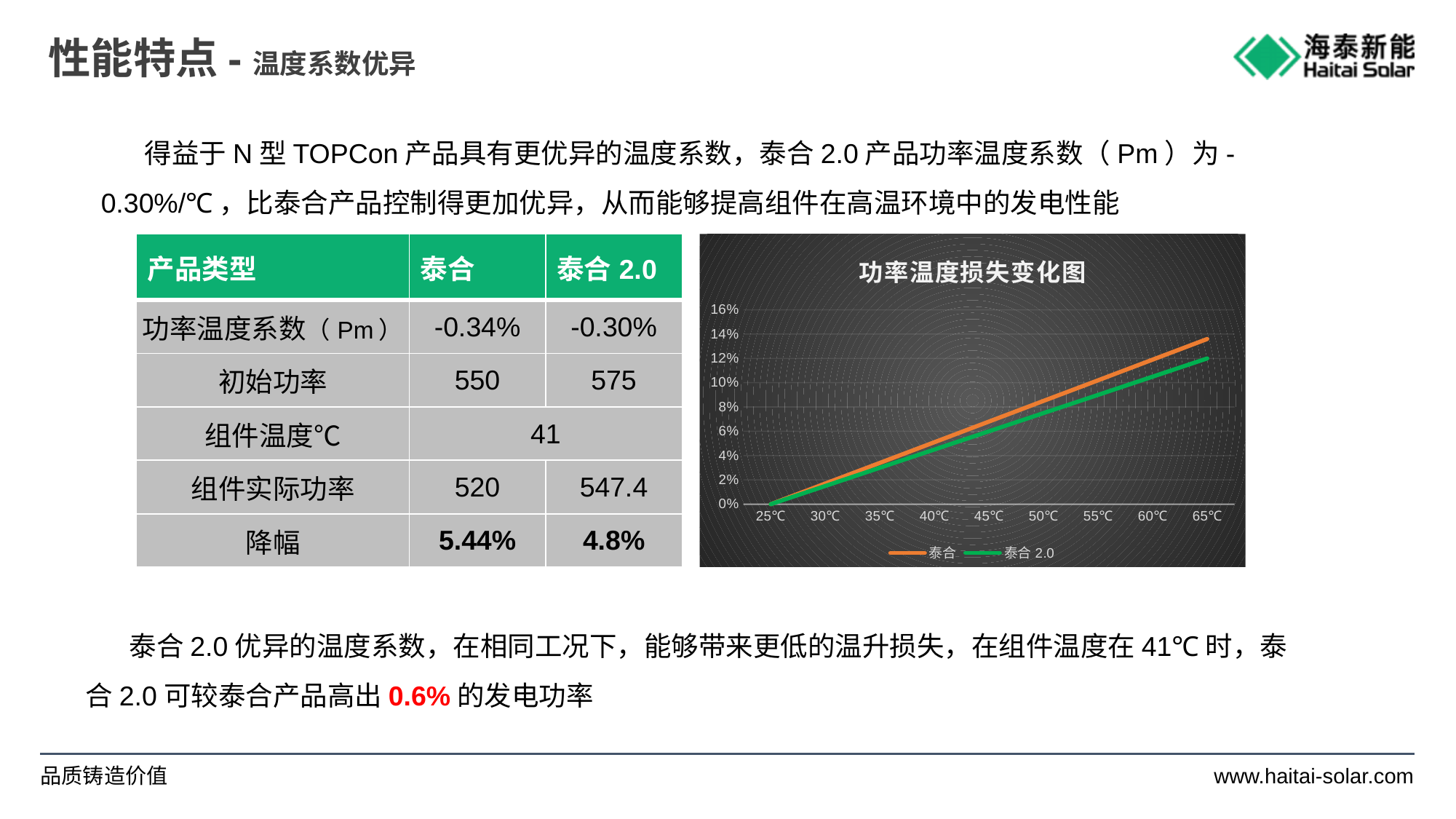
Is the value for 泰合 2.0 at 55℃ greater or less than 10%? less How many temperature points are labelled on the x axis of the chart? 9 How many series does the chart legend list? 2 Is the value for 泰合 at 65℃ greater or less than 12%? greater Do the values in the chart rise or fall as temperature increases along the x axis? rise Is the value for 泰合 at 45℃ greater or less than 6%? greater At 65℃, which series shows the higher power loss, 泰合 or 泰合 2.0? 泰合 What kind of chart is shown on the slide? line chart Which series is drawn in orange in the chart? 泰合 What is the title of the chart? 功率温度损失变化图